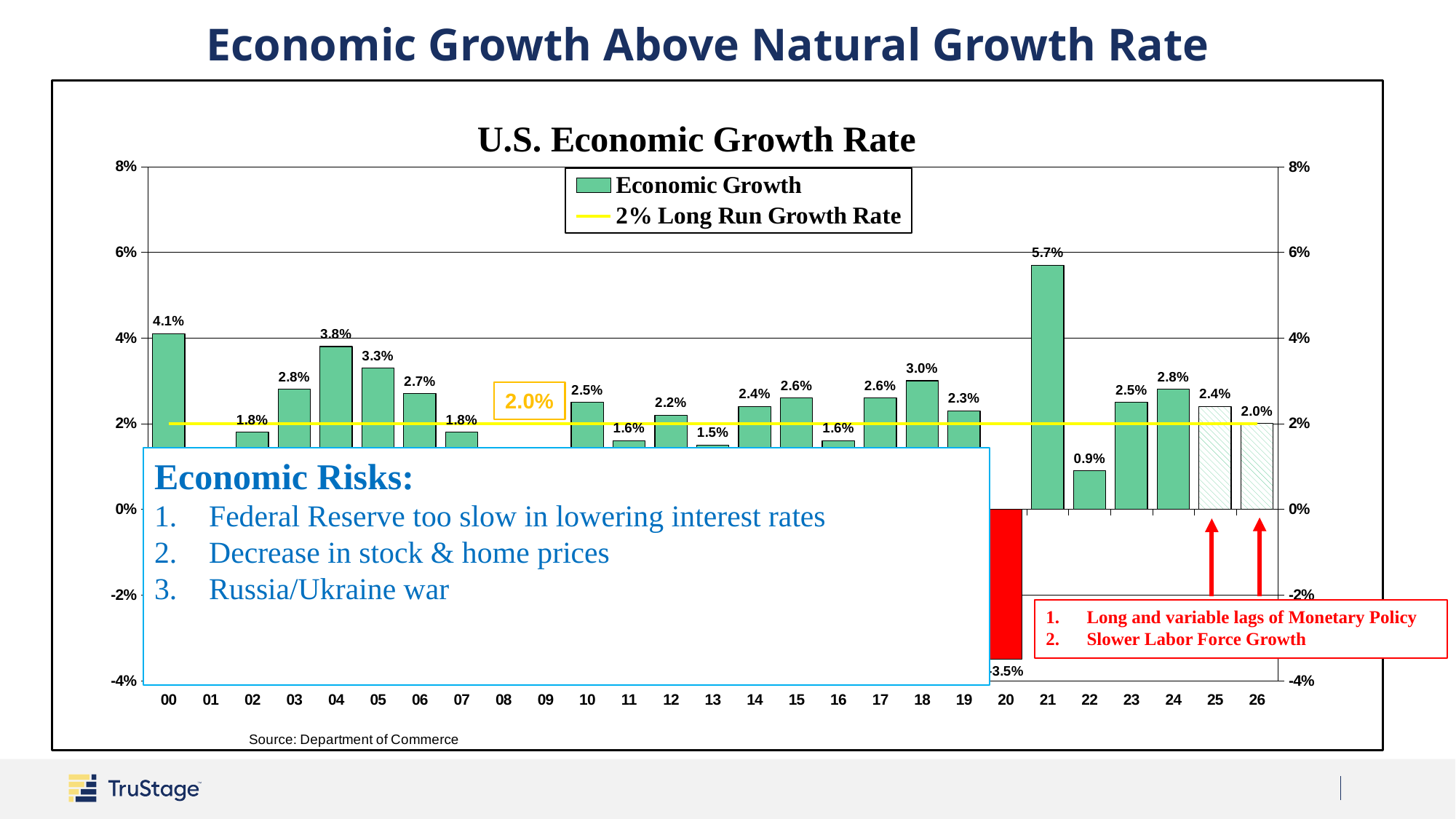
What is the economic growth rate shown for 22? 0.9% What is the economic growth rate shown for 21? 5.7% How many series does the legend list? 2 What is the economic growth rate shown for 18? 3.0% Which year has the larger growth rate, 04 or 05? 04 Which year has the highest economic growth rate? 21 What is the title of the chart? U.S. Economic Growth Rate How many years are shown on the x axis? 27 What is the difference between the growth rates for 21 and 22? 4.8 percentage points What is the economic growth rate shown for 20? -3.5% Is the value for 01 greater or less than 2%? less Which year has the lowest economic growth rate? 20